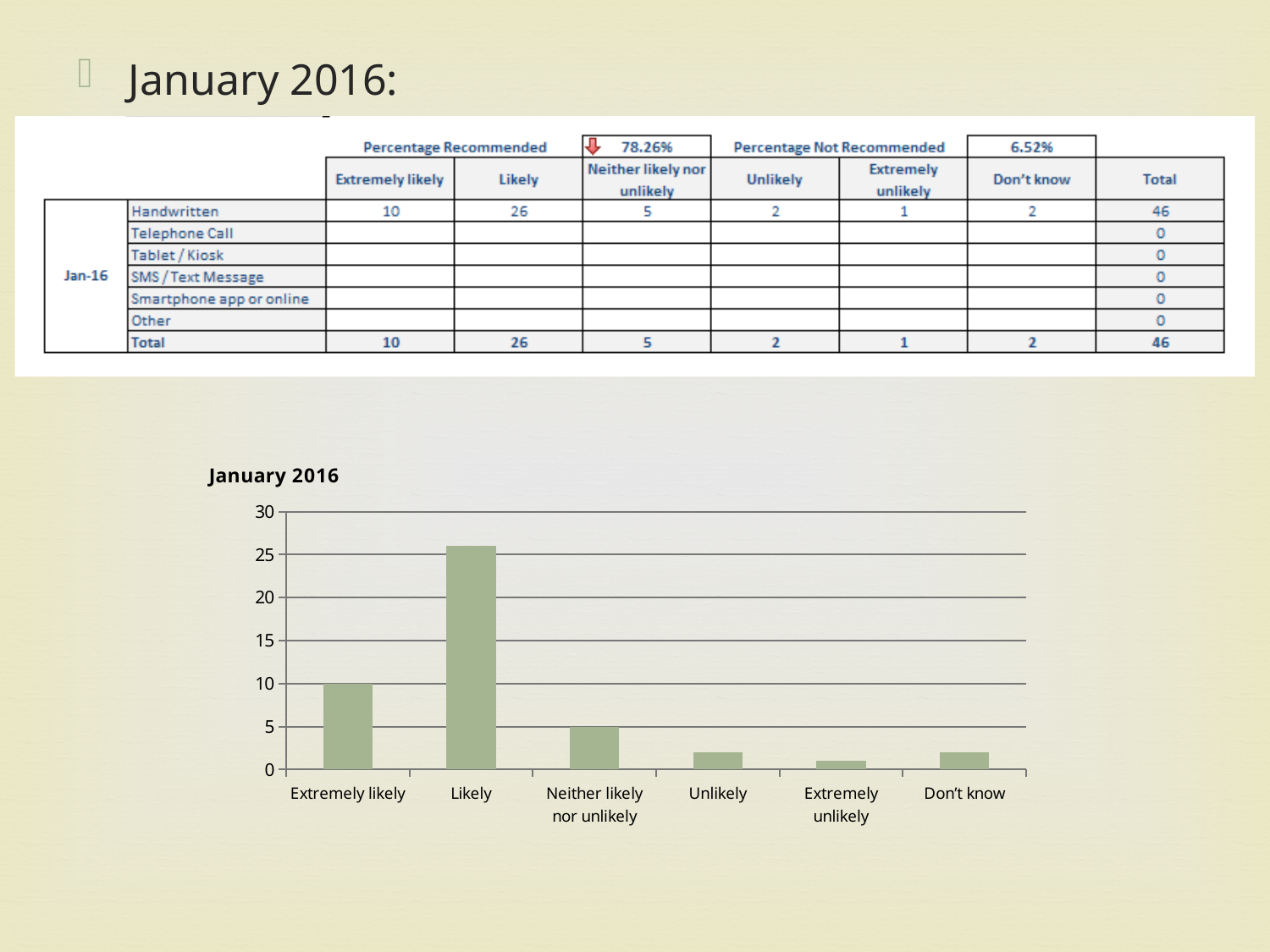
What is the value for Extremely likely in the chart? 10 What type of chart is shown on the slide? bar chart What is the title of the chart? January 2016 How many categories are shown on the x axis of the chart? 6 Which category has the lowest bar in the chart? Extremely unlikely Which category has the highest bar in the chart? Likely What is the difference between the value for Extremely likely and the value for Neither likely nor unlikely? 5 Is the value for Unlikely greater or less than 5? less Is the value for Likely greater or less than 25? greater Is the value for Don't know greater or less than 5? less What is the value for Neither likely nor unlikely in the chart? 5 Which is larger, the value for Extremely likely or the value for Neither likely nor unlikely? Extremely likely